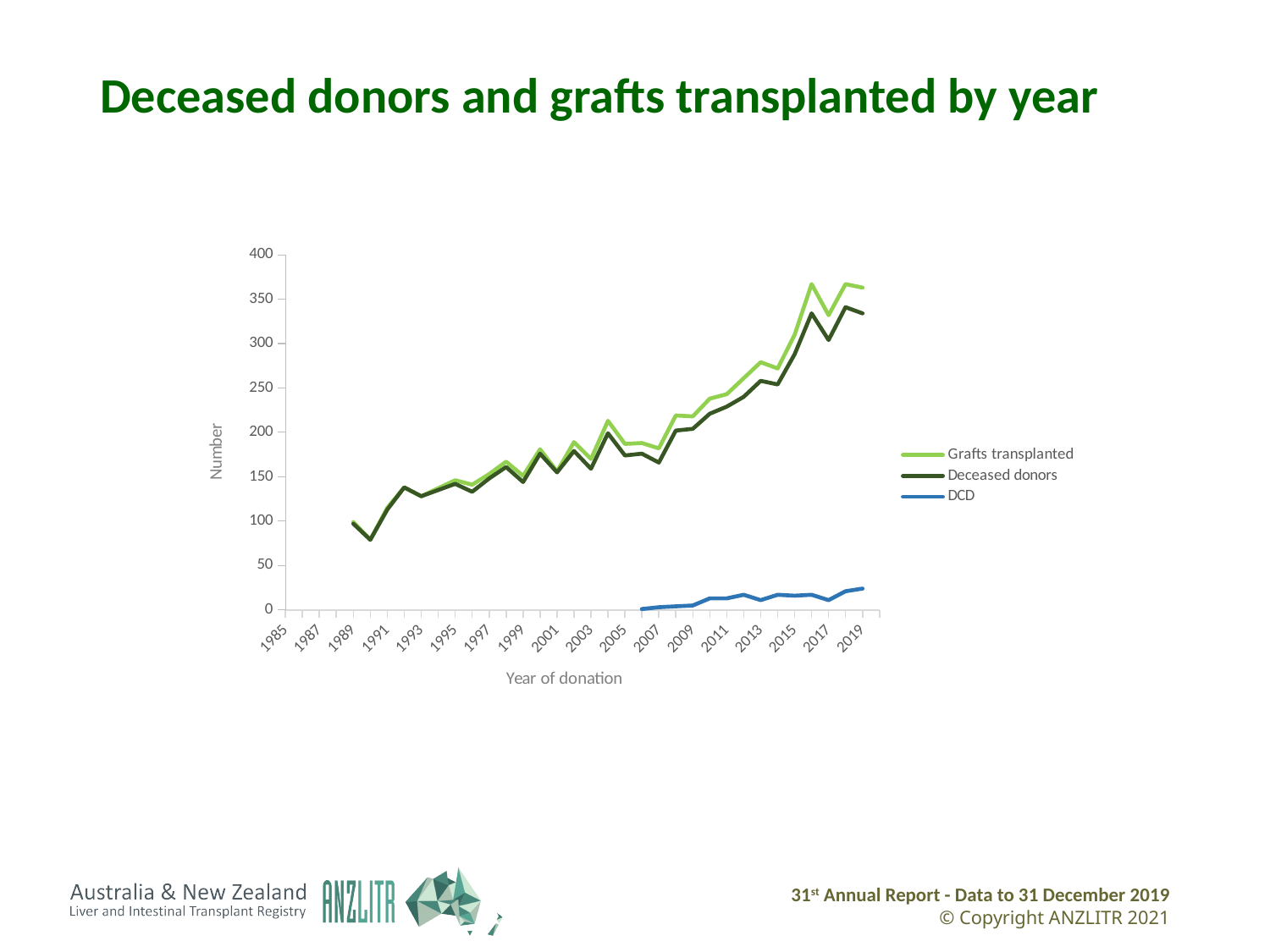
How many series does the legend list? 3 Is the value for Grafts transplanted in 2019 greater or less than 350? greater Is the value for Deceased donors in 1989 greater or less than 150? less In 2019, which is larger: Grafts transplanted or Deceased donors? Grafts transplanted Which series has the highest value in 2019? Grafts transplanted What is the title of the chart? Deceased donors and grafts transplanted by year Is the value for DCD in 2019 greater or less than 50? less Do the values for Grafts transplanted generally rise or fall from 1989 to 2019? rise What kind of chart is shown on the slide? Line chart What is the label on the x axis of the chart? Year of donation Which series has the lowest value in 2019? DCD